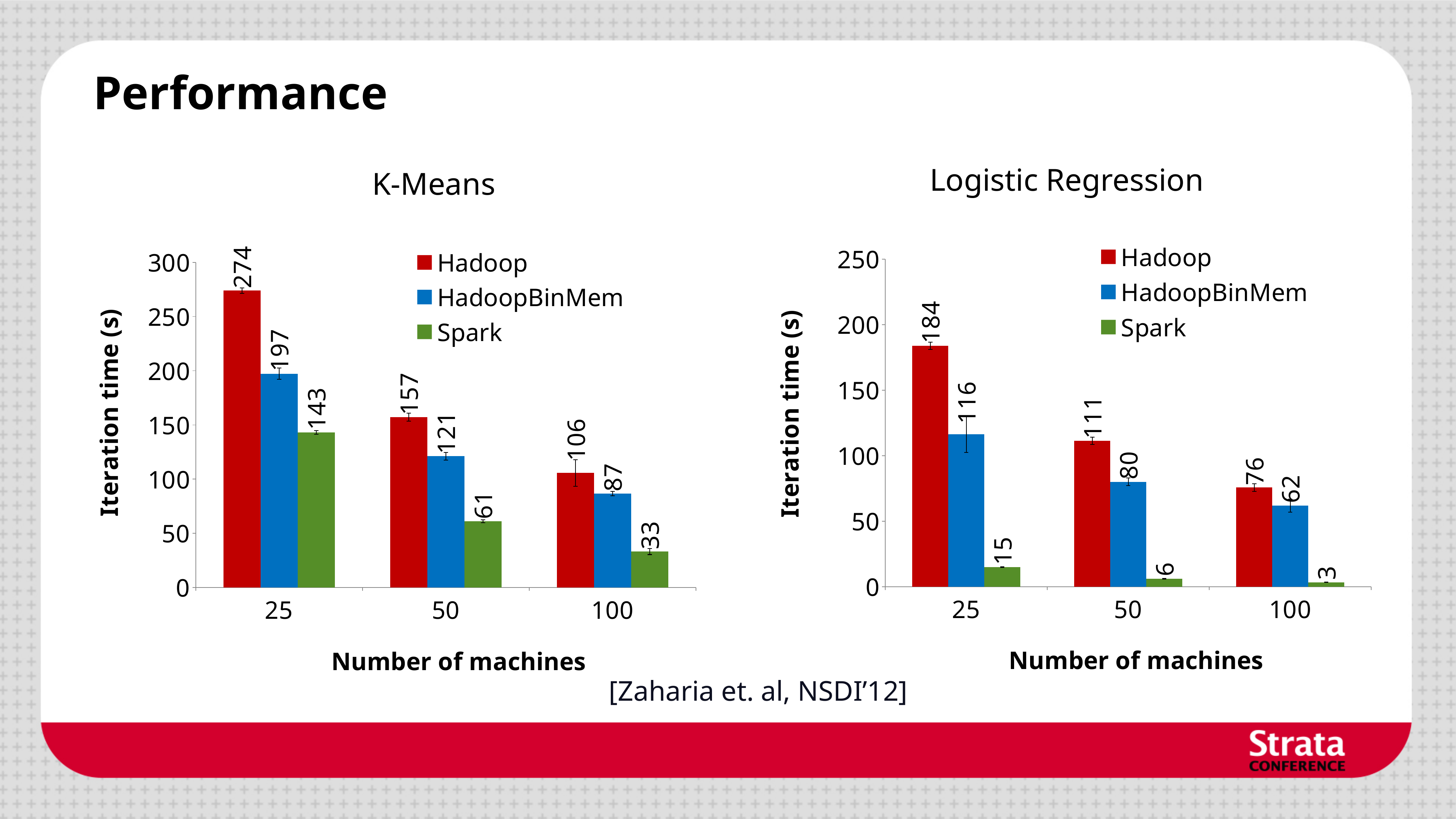
What kind of chart is the K-Means chart? Bar chart How many machine-count categories are shown on the x axis of the Logistic Regression chart? 3 In the Logistic Regression chart, which is larger: the Hadoop iteration time at 100 machines or the HadoopBinMem iteration time at 50 machines? HadoopBinMem at 50 machines How many series does the legend of the K-Means chart list? 3 In the K-Means chart, what is the iteration time for HadoopBinMem with 50 machines? 121 In the K-Means chart, what is the iteration time for Hadoop with 25 machines? 274 In the K-Means chart, which series has the lowest iteration time at 100 machines? Spark In the Logistic Regression chart, what is the iteration time for Spark with 100 machines? 3 In the Logistic Regression chart, does the Hadoop iteration time rise or fall as the number of machines increases? Fall In the Logistic Regression chart, what is the difference between the HadoopBinMem and Spark iteration times at 50 machines? 74 In the K-Means chart, what is the difference between the Hadoop and Spark iteration times at 25 machines? 131 In the Logistic Regression chart, which series has the highest iteration time at 25 machines? Hadoop